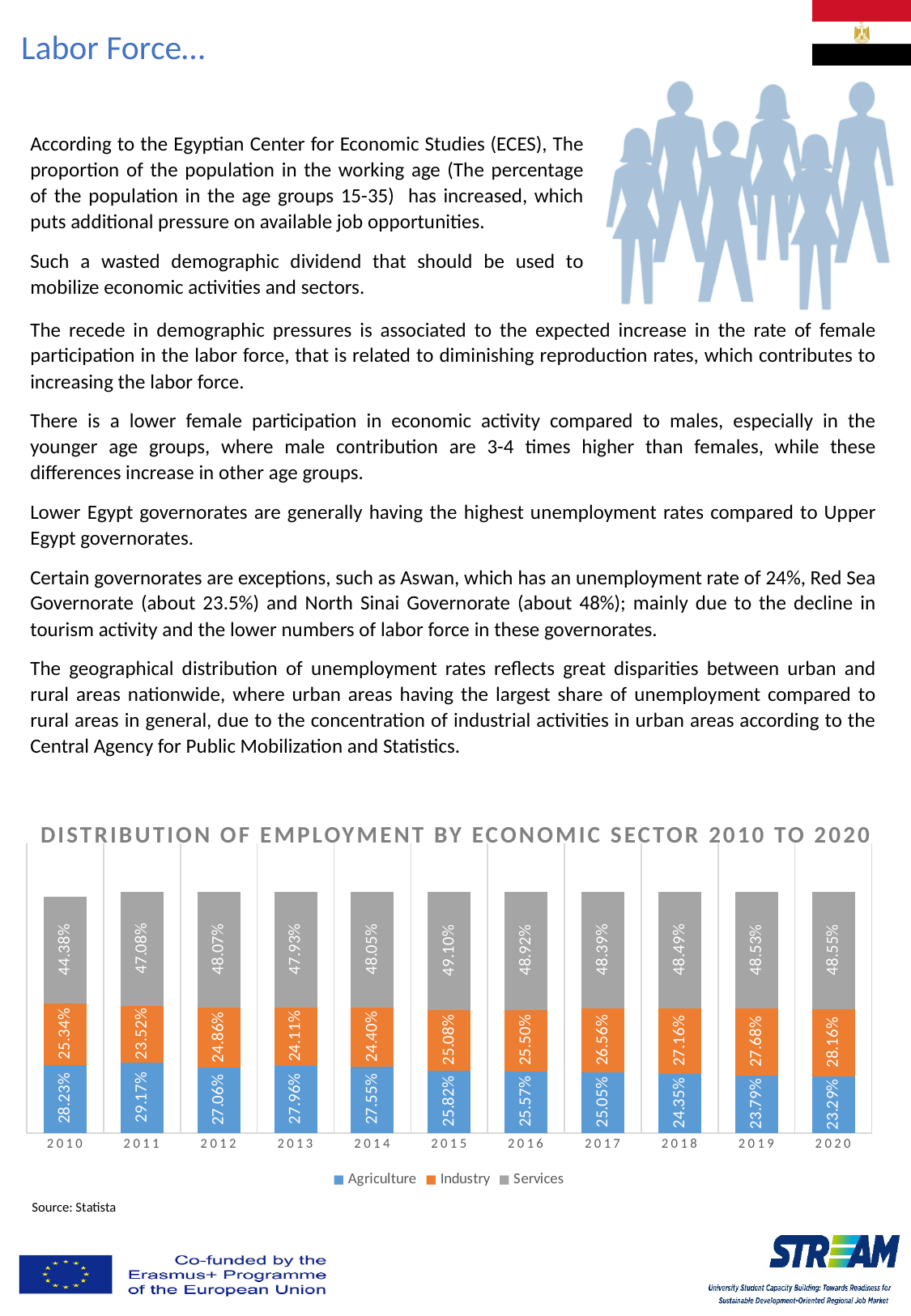
In which year is the Agriculture share highest? 2011 Does the Industry share rise or fall from 2011 to 2020? Rise By how many percentage points did the Industry share change from 2010 to 2020? 2.82 percentage points Which is larger in 2016, the Agriculture share or the Industry share? Agriculture What is the Services share of employment in 2015? 49.10% What is the Industry share of employment in 2017? 26.56% In which year is the Services share lowest? 2010 What kind of chart is shown? Stacked bar chart How many series does the legend list? 3 How many years are shown on the x axis? 11 What is the Agriculture share of employment in 2010? 28.23% In which year is the Agriculture share lowest? 2020